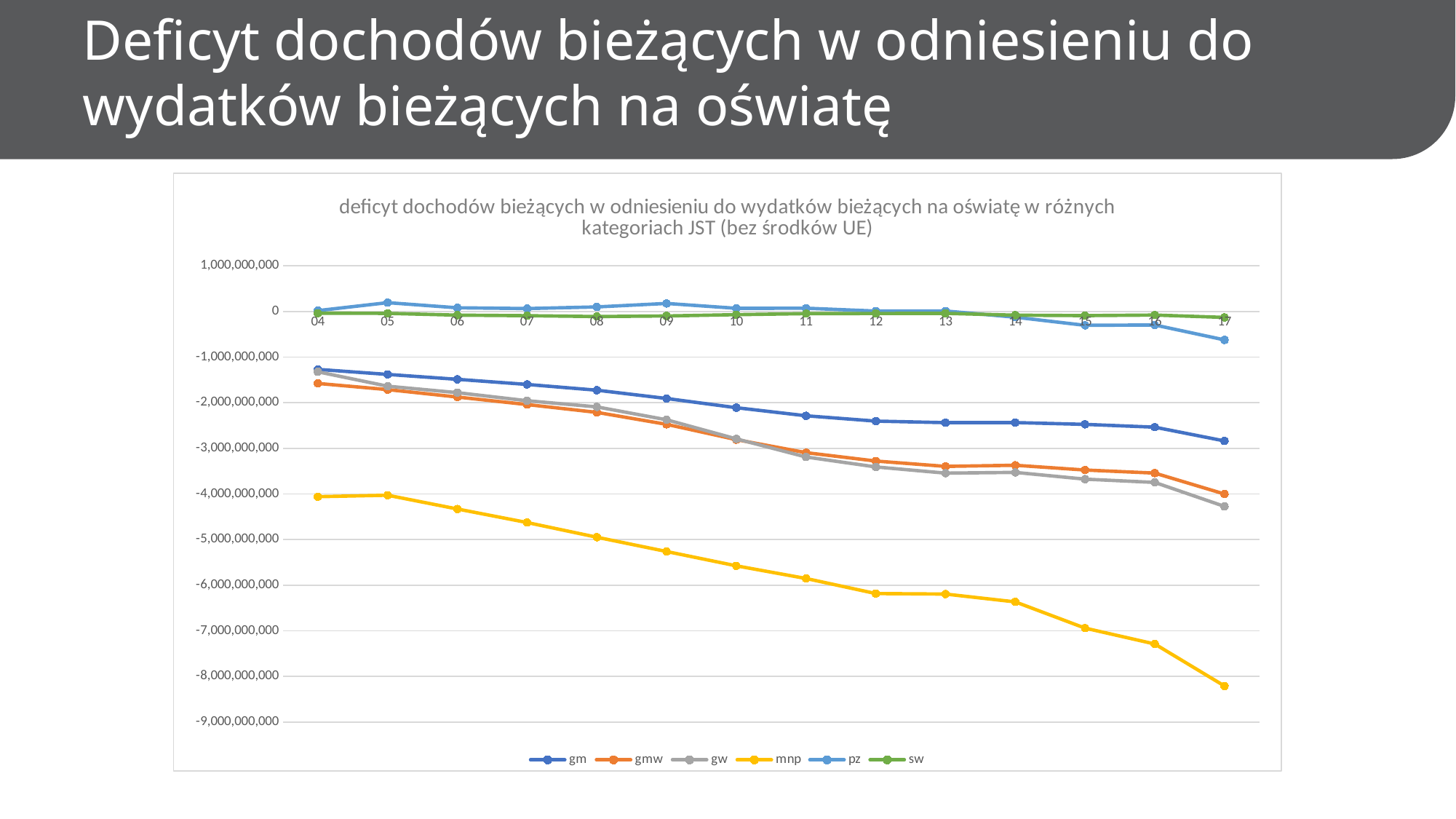
Is the value for mnp in year 10 greater or less than -5,000,000,000? less In year 17, which series has the larger value, gmw or gw? gmw In year 17, which series has the larger value, gm or mnp? gm Is the value for mnp in year 17 greater or less than -8,000,000,000? less Which series has the lowest value in year 17? mnp Which series has the highest value in year 05? pz Is the value for gm in year 17 greater or less than -3,000,000,000? greater Does the mnp series rise or fall from 04 to 17? fall Which series is drawn in yellow? mnp How many years are plotted along the x axis? 14 What kind of chart is shown on the slide? line chart How many series does the legend list? 6